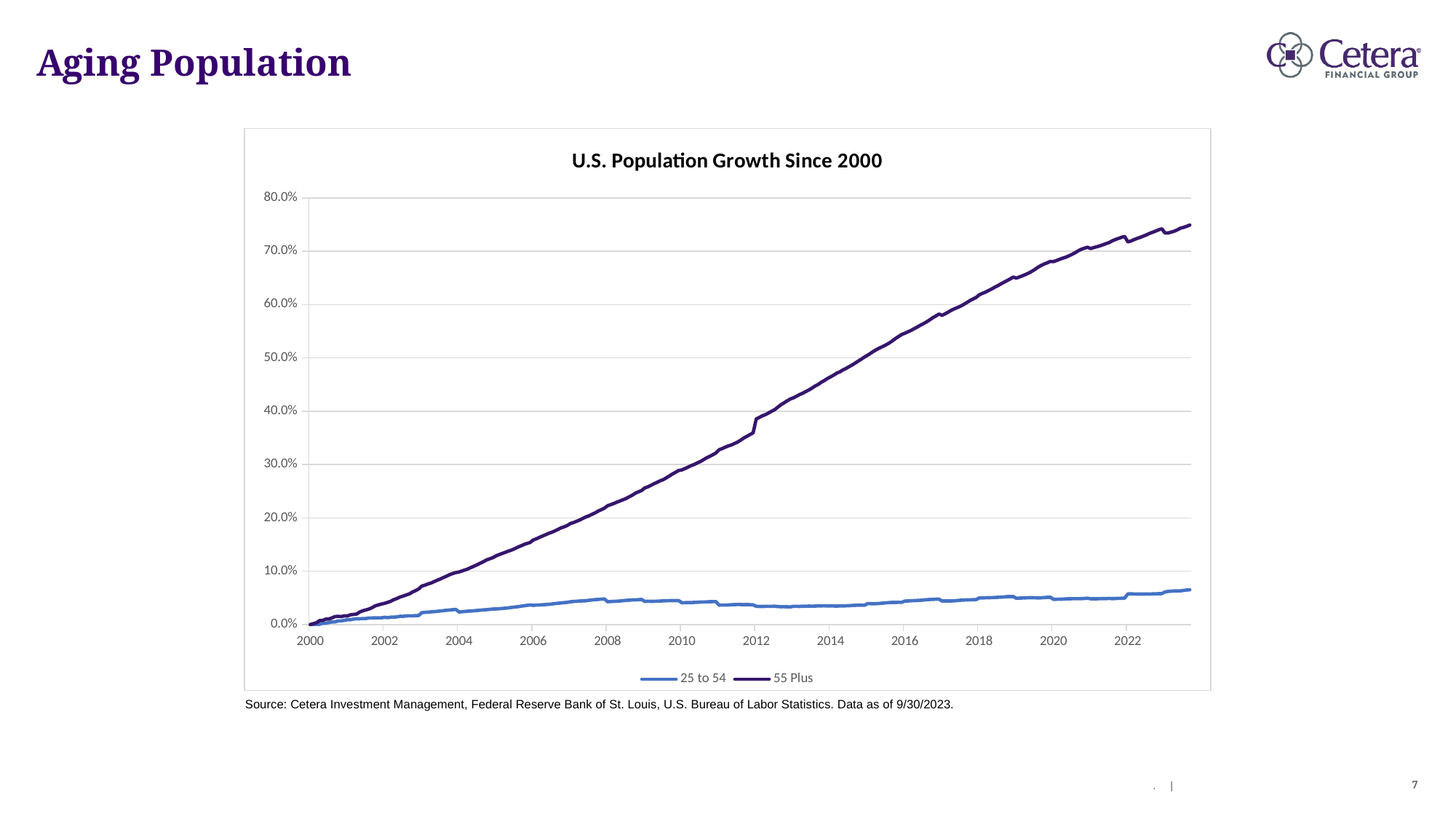
Which series is drawn in the darker purple line? 55 Plus Does the 55 Plus line rise or fall from 2000 to 2022? Rise Which series is higher in 2020, 25 to 54 or 55 Plus? 55 Plus Is the value for 25 to 54 in 2022 greater or less than 10.0%? less Is the value for 55 Plus in 2016 greater or less than 50.0%? greater Is the value for 55 Plus in 2012 greater or less than 30.0%? greater Which series reaches the highest value on the chart? 55 Plus How many series does the chart's legend list? 2 What kind of chart is shown on the slide? Line chart What is the title of the chart? U.S. Population Growth Since 2000